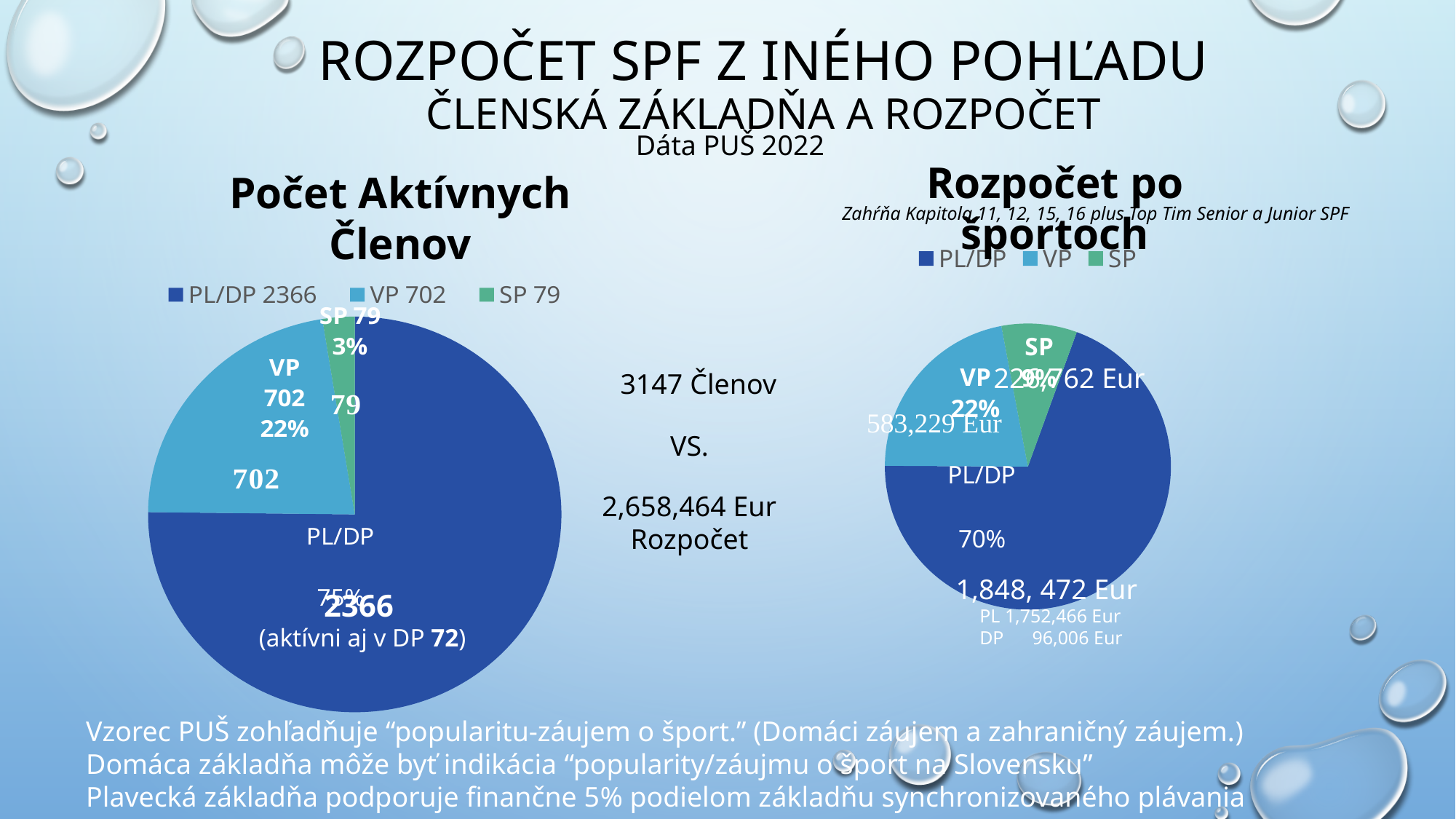
In the chart titled "Počet Aktívnych Členov", which category has the smallest slice? SP In the chart titled "Rozpočet po športoch", what is the budget value shown for VP? 583,229 Eur In the chart titled "Počet Aktívnych Členov", how many members are in the PL/DP slice? 2366 In the chart titled "Počet Aktívnych Členov", how many slices does the pie have? 3 In the chart titled "Počet Aktívnych Členov", what is the difference between the VP and SP member counts? 623 In the chart titled "Počet Aktívnych Členov", what share of the pie does SP hold? 3% In the chart titled "Počet Aktívnych Členov", what share of the pie does VP hold? 22% In the chart titled "Rozpočet po športoch", what share of the pie does PL/DP hold? 70% In the chart titled "Počet Aktívnych Členov", what kind of chart is shown? pie chart In the chart titled "Rozpočet po športoch", which is larger, the PL/DP slice or the VP slice? PL/DP In the chart titled "Rozpočet po športoch", how many entries does the legend list? 3 In the chart titled "Počet Aktívnych Členov", which category has the largest slice? PL/DP